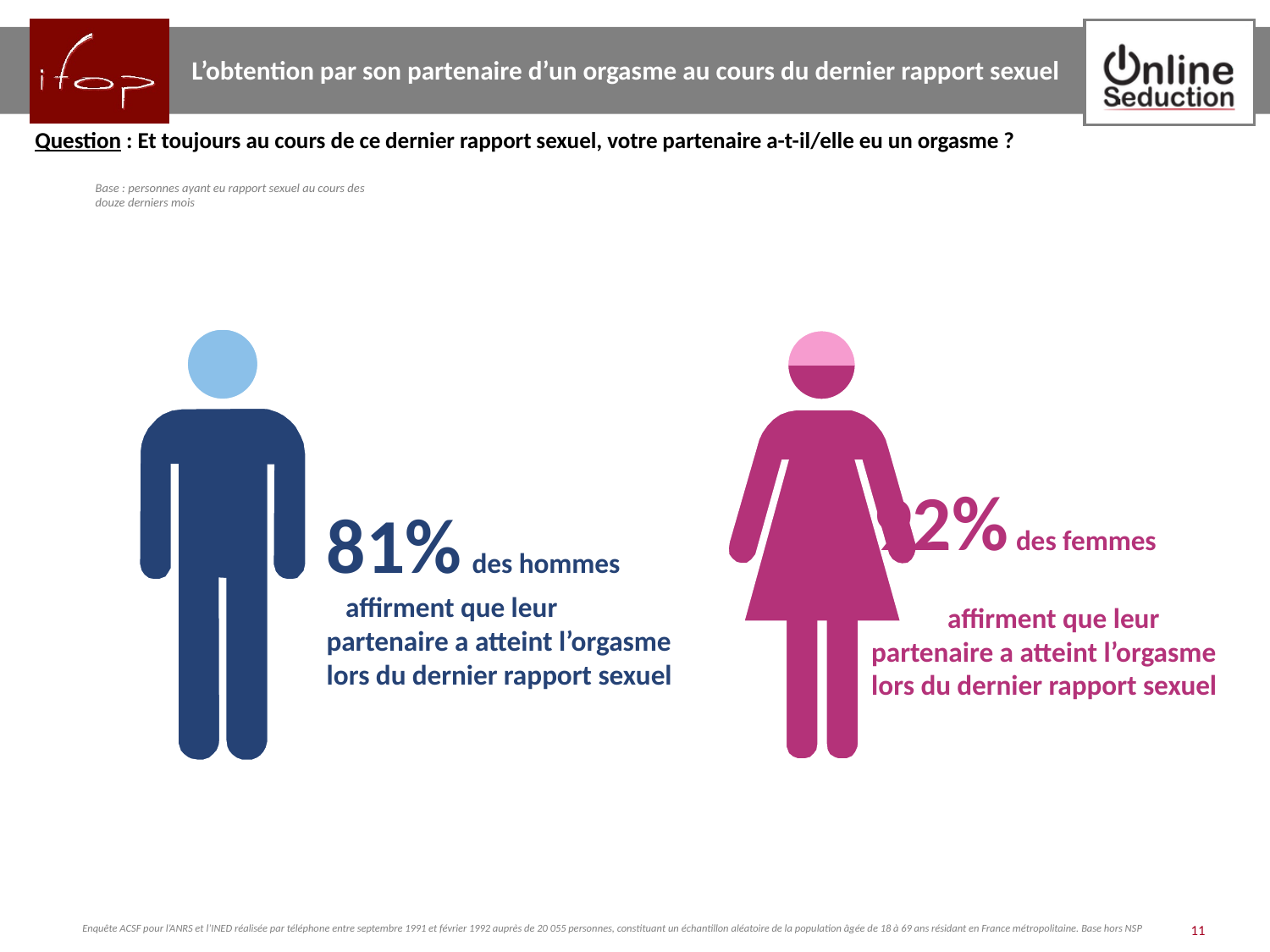
What colour is the female figure on the slide? Pink/magenta Is the value shown for men (des hommes) greater or less than 80%? greater What percentage of men (des hommes) affirm that their partner reached orgasm during their last sexual encounter? 81% How many groups (genders) are shown with a figure on the slide? 2 What colour is the male figure on the slide? Dark blue